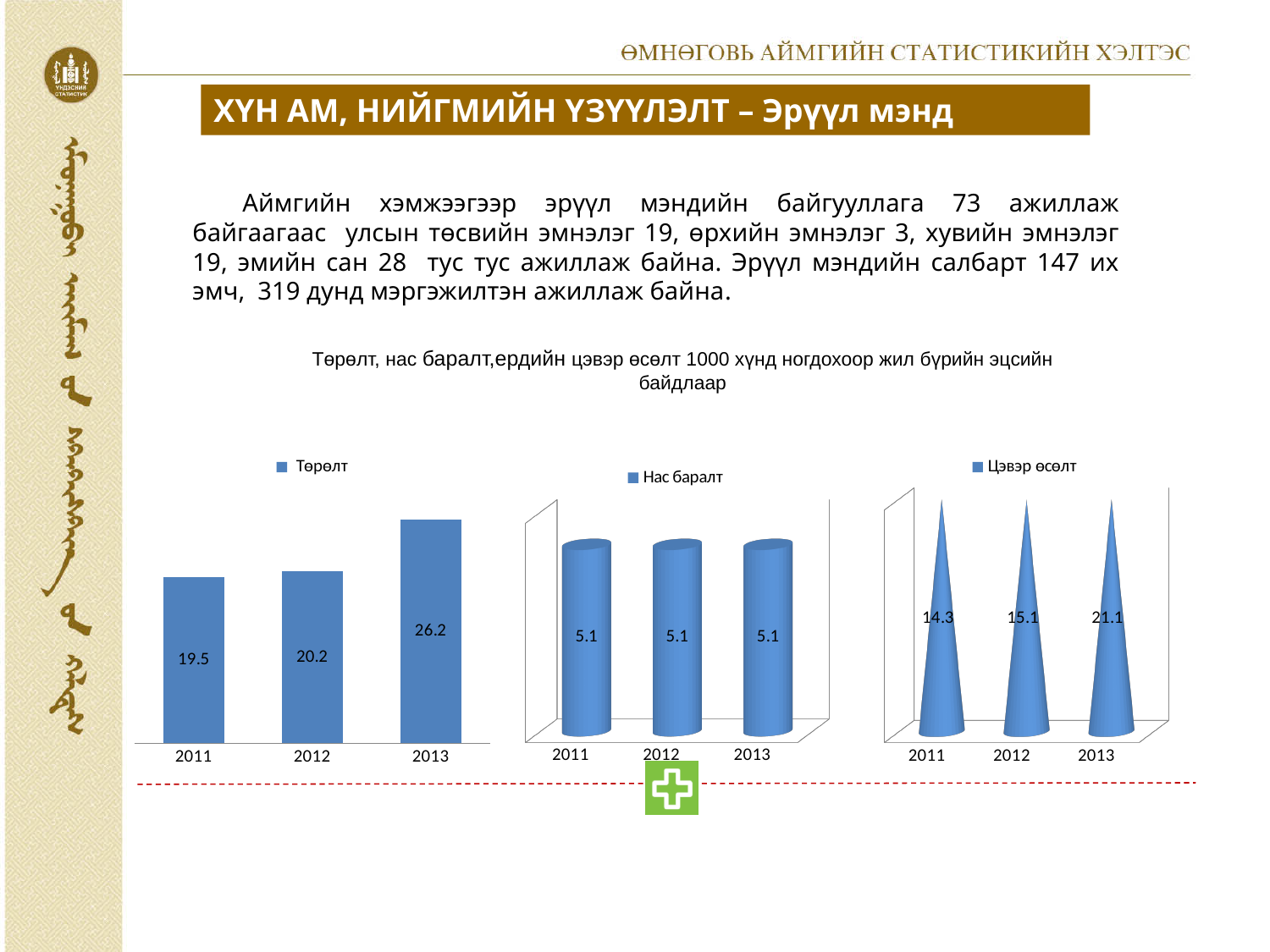
In the middle chart (Нас баралт), how many years are shown? 3 In the left chart (Төрөлт), what is the difference between the 2013 and 2011 values? 6.7 In the middle chart (Нас баралт), what is the value for 2012? 5.1 What kind of chart is the left chart (Төрөлт)? bar chart In the left chart (Төрөлт), do the values rise or fall from 2011 to 2013? rise In the right chart (Цэвэр өсөлт), which year has the lowest value? 2011 In the right chart (Цэвэр өсөлт), what is the difference between the 2013 and 2012 values? 6.0 In the right chart (Цэвэр өсөлт), what is the value for 2013? 21.1 In the left chart (Төрөлт), what is the value for 2013? 26.2 In the left chart (Төрөлт), which year has the highest value? 2013 In the right chart (Цэвэр өсөлт), is the value for 2012 larger than the value for 2011? yes In the left chart (Төрөлт), what is the value for 2011? 19.5